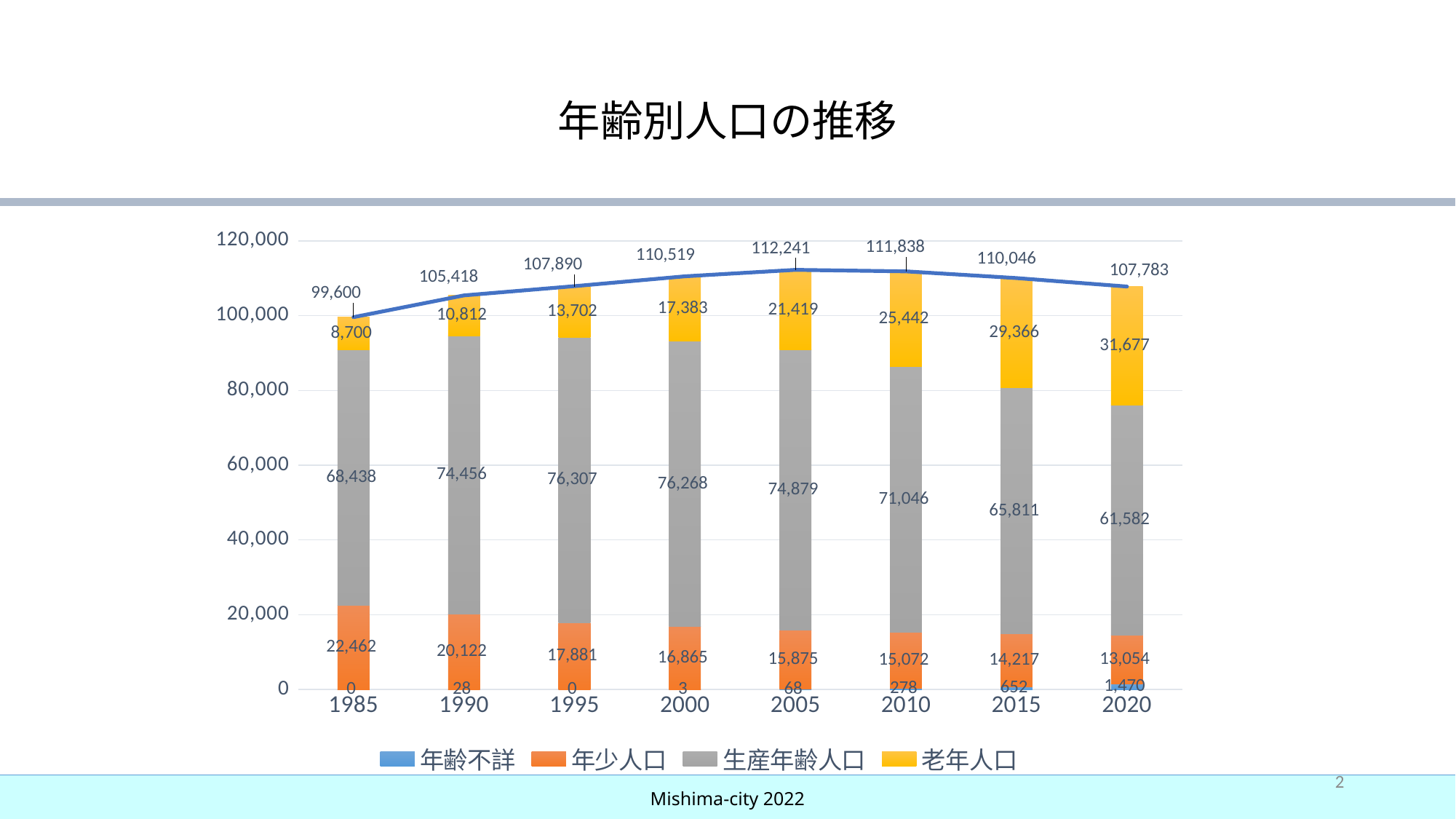
What is the value of 年齢不詳 in 2015? 652 Which year has the lowest value for 生産年齢人口? 2020 What is the difference between 老年人口 in 2020 and in 1985? 22,977 What is the value of 年少人口 in 1985? 22,462 Does 老年人口 rise or fall from 1985 to 2020? rise What is the value of 老年人口 in 2020? 31,677 What is the total of the stacked bar for 2010? 111,838 What is the value of 生産年齢人口 in 1995? 76,307 Which is larger, 年少人口 in 1990 or 年少人口 in 2010? 1990 Which year has the highest total population shown on the line? 2005 How many years are shown on the x axis? 8 How many series does the legend list? 4